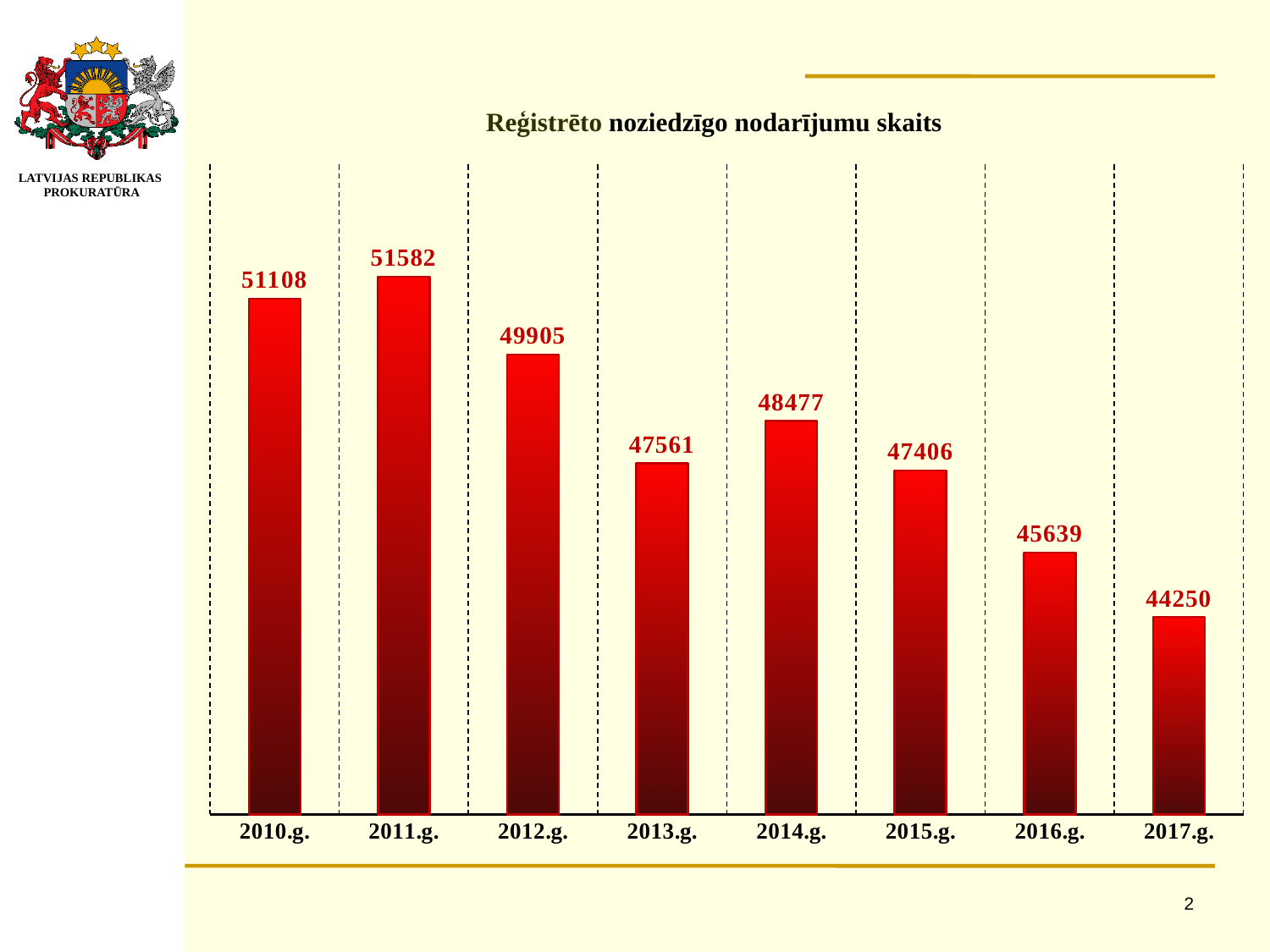
What kind of chart is shown on the slide? bar chart What is the value for 2010.g.? 51108 Which year has the highest value? 2011.g. What is the title of the chart? Reģistrēto noziedzīgo nodarījumu skaits What is the value for 2014.g.? 48477 What is the value for 2017.g.? 44250 Which is larger, the value for 2013.g. or the value for 2015.g.? 2013.g. Which year has the lowest value? 2017.g. How many years are shown on the chart? 8 Do the values generally rise or fall from 2011.g. to 2017.g.? fall What is the difference between the values for 2011.g. and 2010.g.? 474 What is the difference between the values for 2016.g. and 2017.g.? 1389